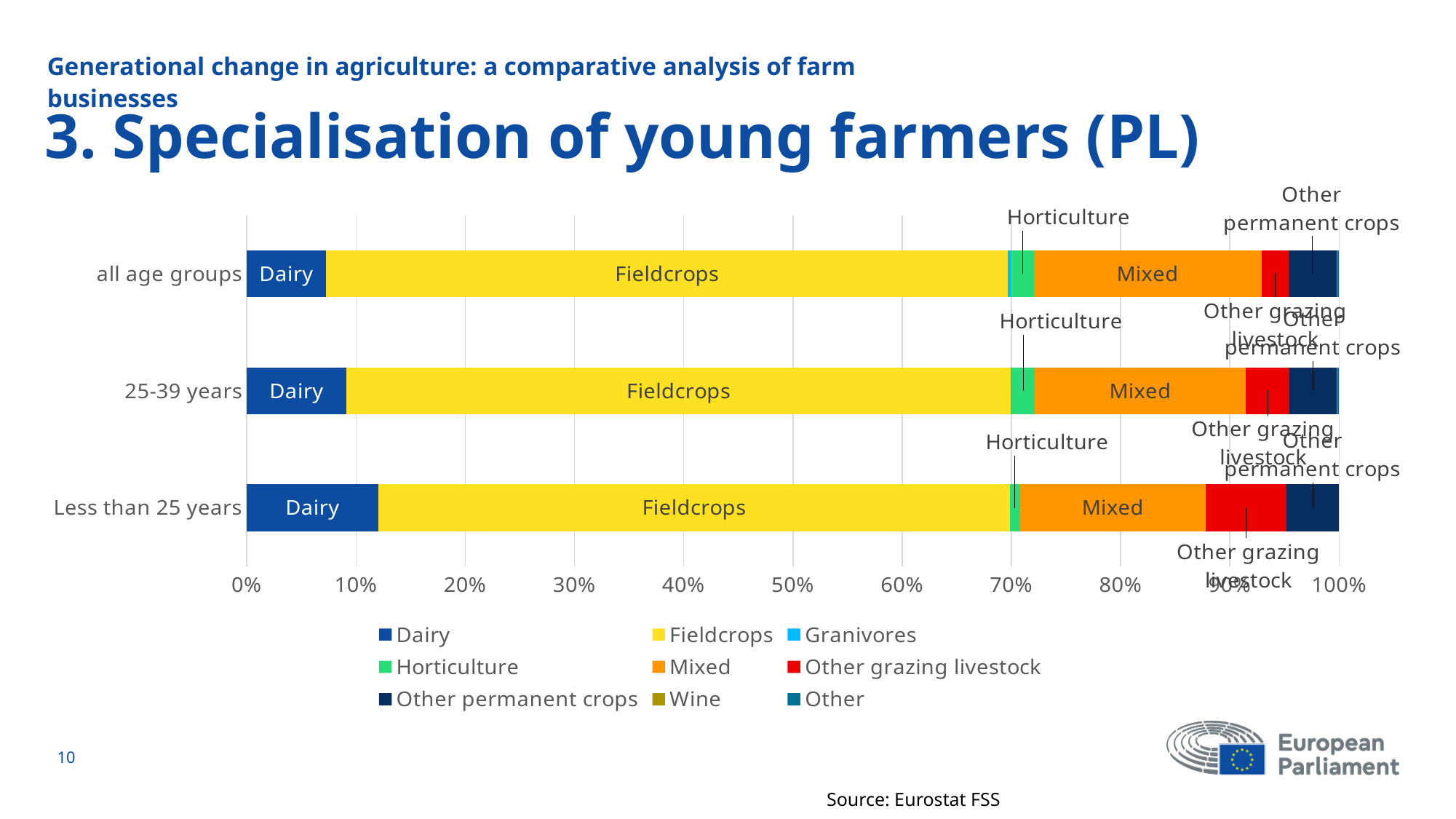
Is the Fieldcrops share for Less than 25 years greater or less than 50%? greater How many age-group categories are plotted on the chart? 3 What is the data source cited for the chart? Eurostat FSS Which is larger, the Fieldcrops share for all age groups or for Less than 25 years? all age groups Is the Dairy share for Less than 25 years greater or less than 10%? greater Is the Dairy share for all age groups greater or less than 10%? less What colour represents Fieldcrops in the chart? Yellow Which is larger, the Mixed share for all age groups or for Less than 25 years? all age groups Which age group has the largest Dairy share? Less than 25 years Which age group has the largest Other grazing livestock share? Less than 25 years What kind of chart is shown on the slide? Stacked bar chart How many series does the legend list? 9